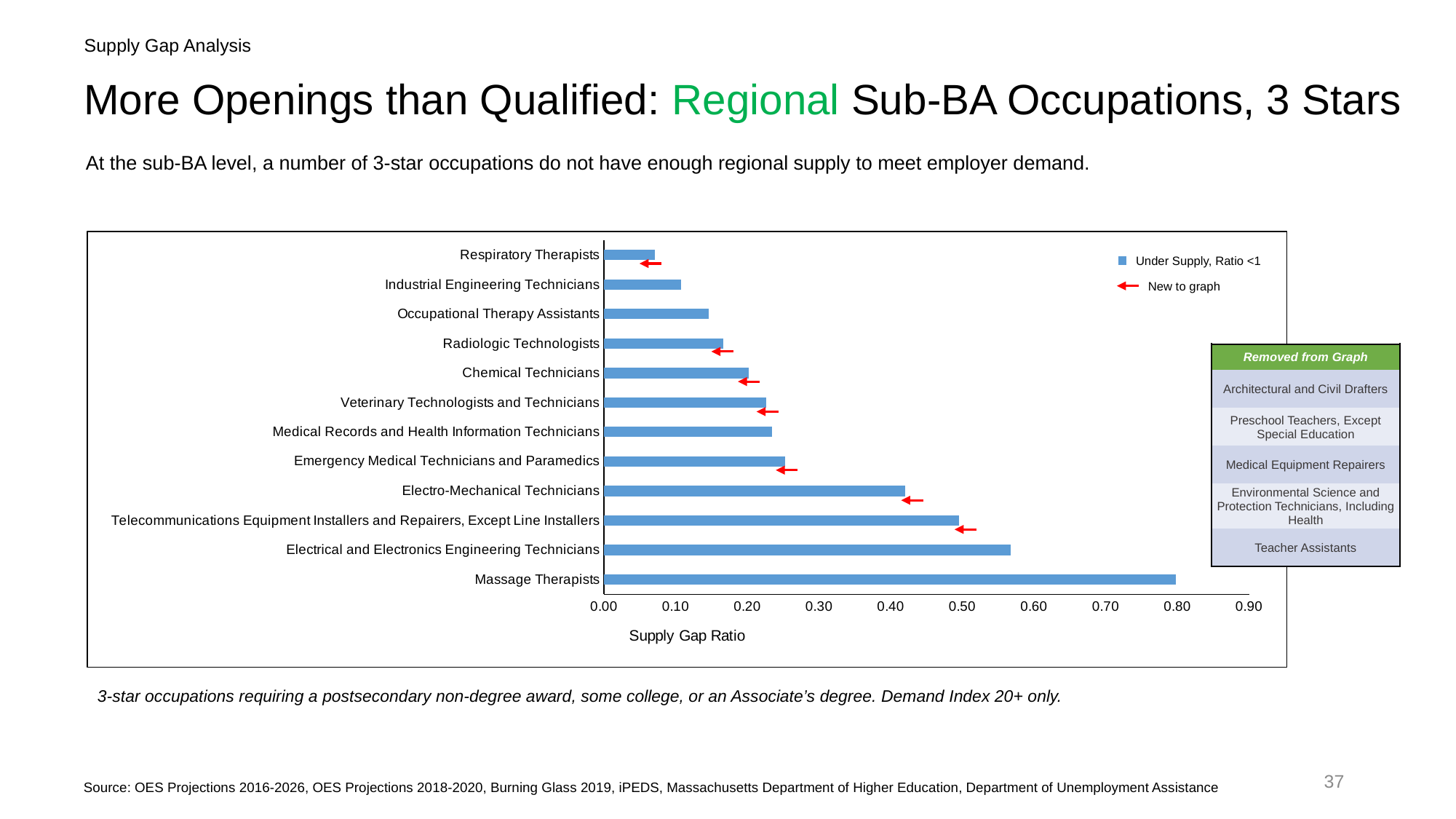
Which occupation has the lowest supply gap ratio in the chart? Respiratory Therapists Is the supply gap ratio for Electrical and Electronics Engineering Technicians greater or less than 0.50? greater Which occupation has the highest supply gap ratio in the chart? Massage Therapists Is the supply gap ratio for Electro-Mechanical Technicians greater or less than 0.40? greater Is the supply gap ratio for Industrial Engineering Technicians greater or less than 0.20? less What kind of chart is shown on the slide? bar chart Which has a larger supply gap ratio: Electrical and Electronics Engineering Technicians or Telecommunications Equipment Installers and Repairers, Except Line Installers? Electrical and Electronics Engineering Technicians Which has a larger supply gap ratio: Electro-Mechanical Technicians or Emergency Medical Technicians and Paramedics? Electro-Mechanical Technicians What does the red arrow symbol in the chart legend indicate? New to graph How many occupations are plotted in the chart? 12 What is the title of the horizontal axis of the chart? Supply Gap Ratio